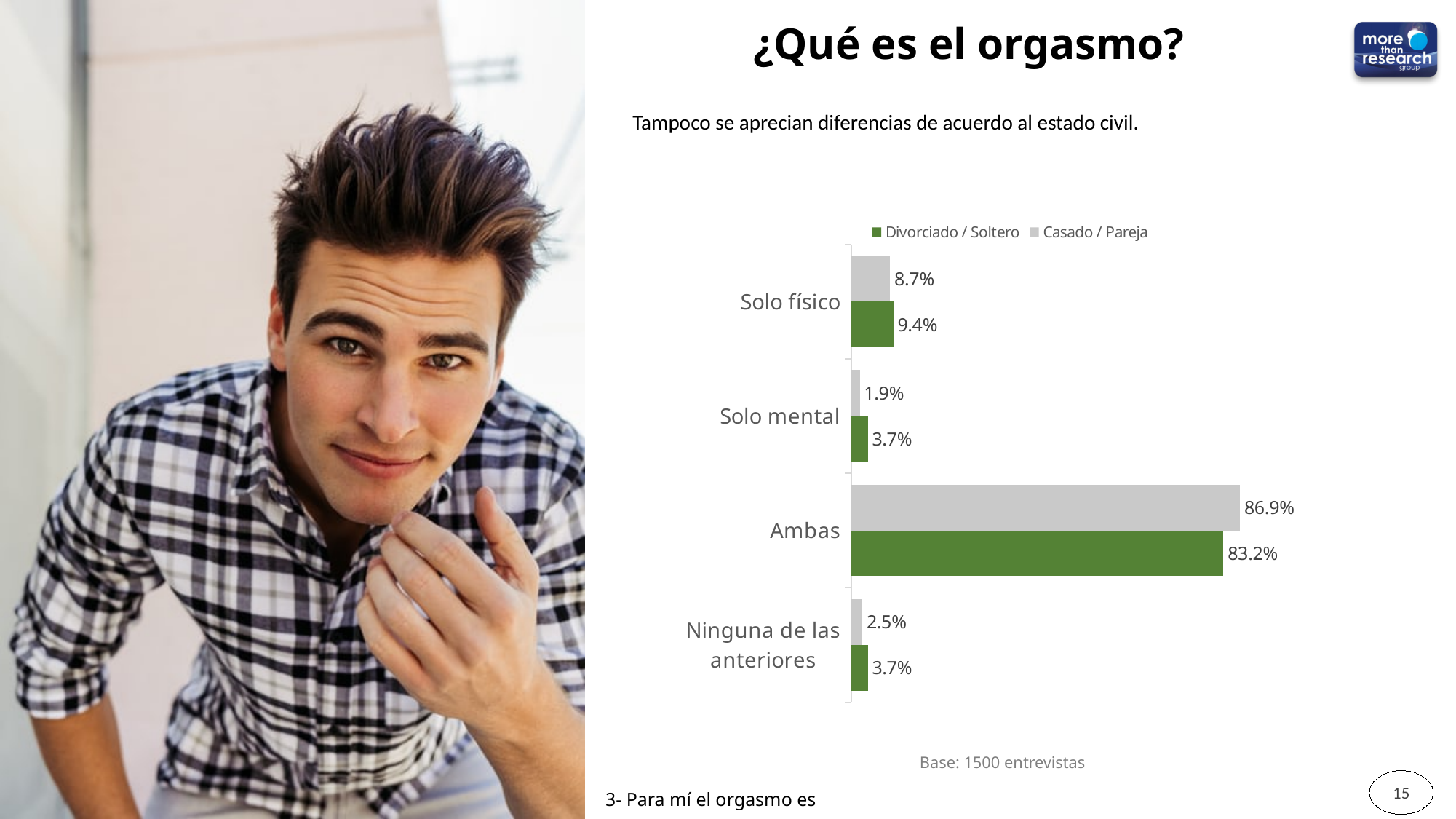
What kind of chart is shown on the slide? Bar chart What is the value for Ambas in the Casado / Pareja series? 86.9% How many series does the legend list? 2 For Solo físico, which series has the larger value: Divorciado / Soltero or Casado / Pareja? Divorciado / Soltero What is the value for Solo mental in the Casado / Pareja series? 1.9% Which category has the highest value in the Divorciado / Soltero series? Ambas What colour are the bars for the Divorciado / Soltero series? Green Which category has the lowest value in the Casado / Pareja series? Solo mental How many categories are shown on the chart? 4 What is the value for Ninguna de las anteriores in the Divorciado / Soltero series? 3.7% What is the difference between the Casado / Pareja and Divorciado / Soltero values for Ambas? 3.7% What is the value for Solo físico in the Divorciado / Soltero series? 9.4%